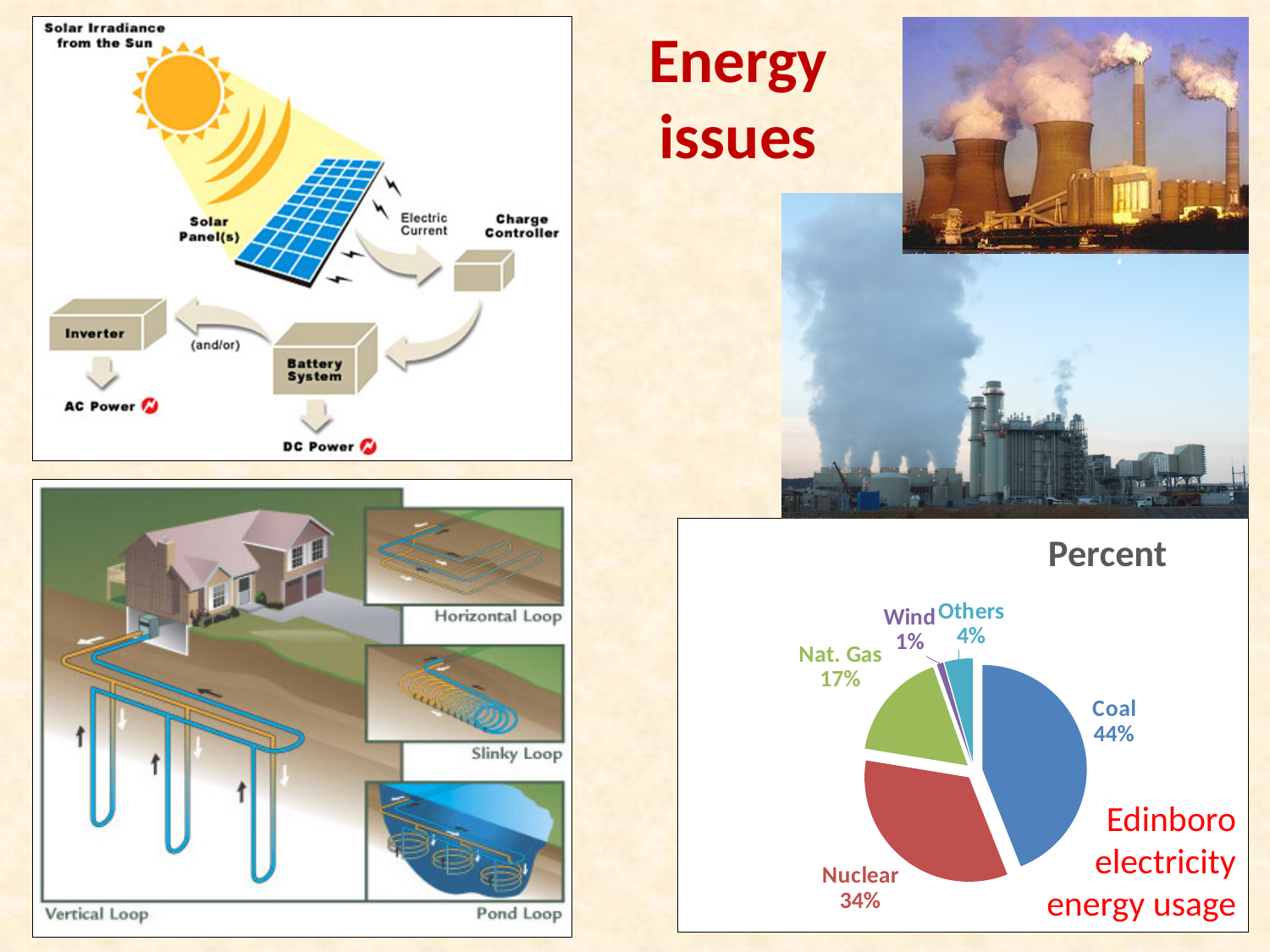
What percentage of the pie chart is Nat. Gas? 17% What percentage of the pie chart is Nuclear? 34% What percentage of the pie chart is Others? 4% What is the title of the pie chart? Percent What type of chart is shown on the slide? pie chart What percentage of the pie chart is Wind? 1% What is the difference in percentage points between Coal and Nuclear in the pie chart? 10 Which category has the smallest slice in the pie chart? Wind What percentage of the pie chart is Coal? 44% Which is larger in the pie chart, Nat. Gas or Others? Nat. Gas How many slices does the pie chart have? 5 Which category has the largest slice in the pie chart? Coal